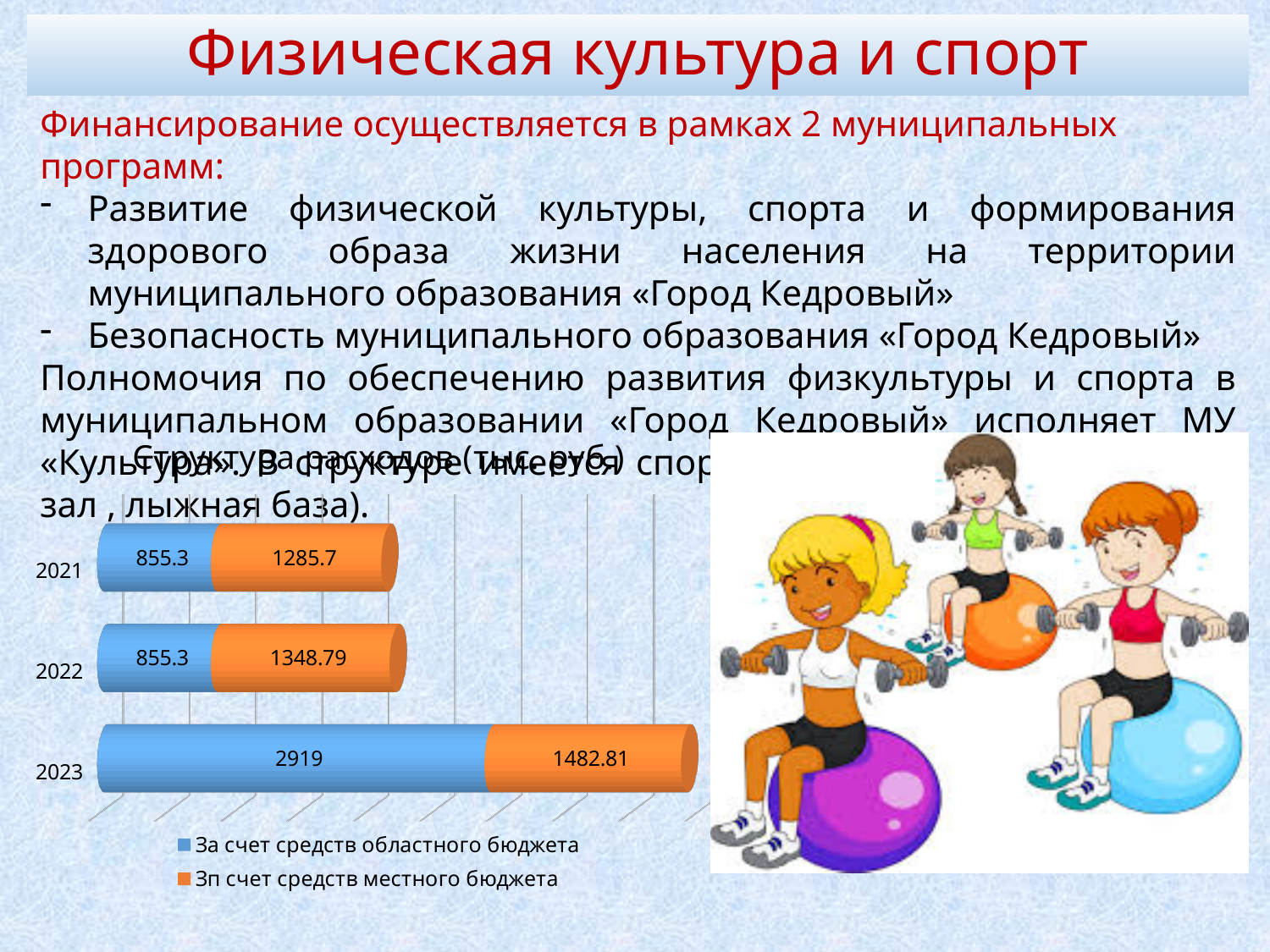
What is the value for 'За счет средств областного бюджета' in 2021? 855.3 Which year has the lowest value for 'Зп счет средств местного бюджета'? 2021 What is the value for 'За счет средств областного бюджета' in 2023? 2919 What is the total of the stacked bar for 2023? 4401.81 Which year has the highest value for 'За счет средств областного бюджета'? 2023 How many series does the legend list? 2 Which is larger in 2023: 'За счет средств областного бюджета' or 'Зп счет средств местного бюджета'? За счет средств областного бюджета What is the difference between the 'Зп счет средств местного бюджета' values for 2023 and 2022? 134.02 What is the value for 'Зп счет средств местного бюджета' in 2021? 1285.7 What is the value for 'Зп счет средств местного бюджета' in 2022? 1348.79 What kind of chart is shown on the slide? Stacked bar chart How many years are shown on the chart? 3